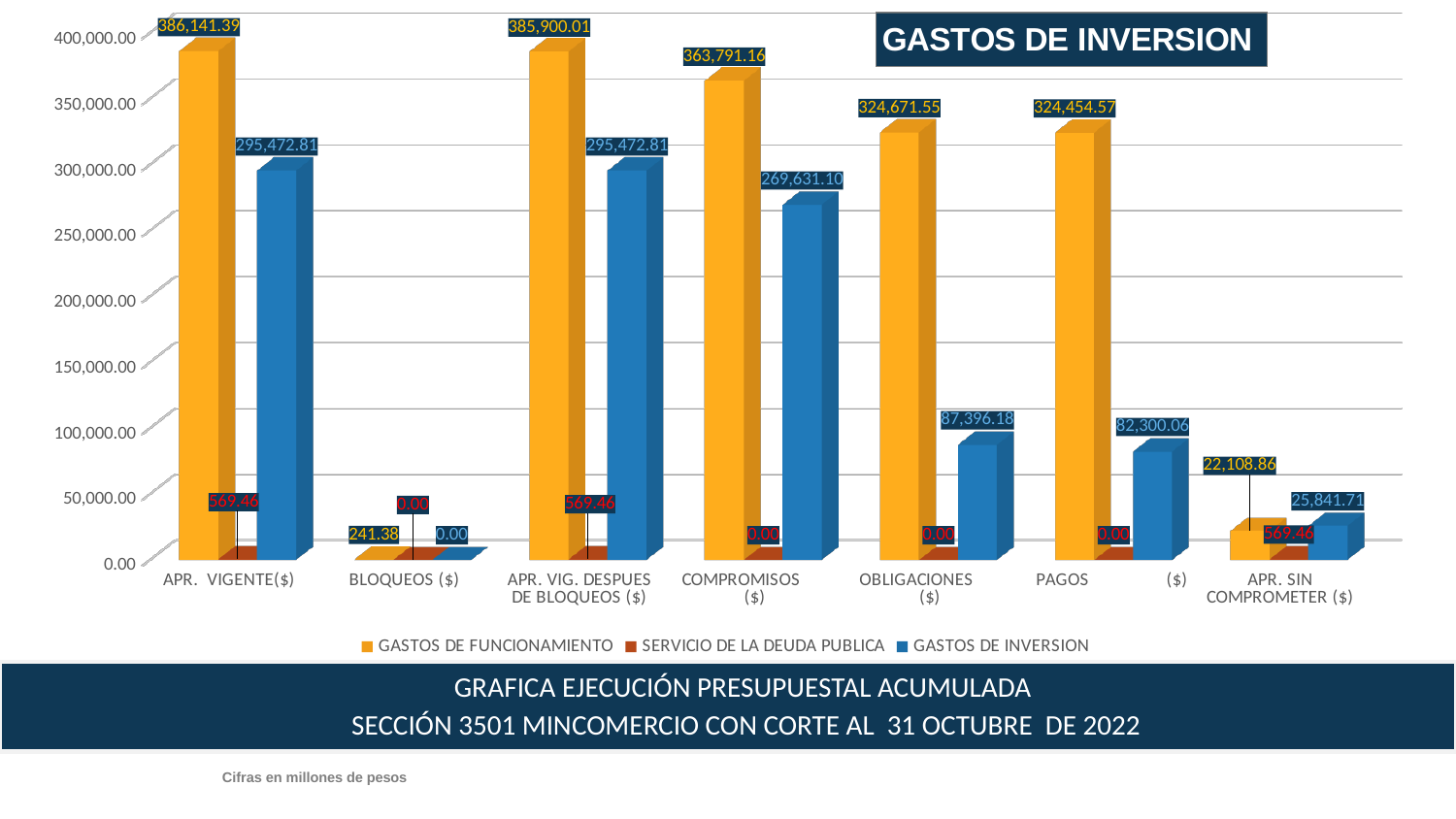
What is the value of GASTOS DE FUNCIONAMIENTO for BLOQUEOS ($)? 241.38 What is the difference between GASTOS DE FUNCIONAMIENTO for APR. VIGENTE($) and for APR. VIG. DESPUES DE BLOQUEOS ($)? 241.38 How many series does the legend list? 3 Which is larger for GASTOS DE INVERSION: OBLIGACIONES ($) or PAGOS ($)? OBLIGACIONES ($) What is the value of GASTOS DE INVERSION for OBLIGACIONES ($)? 87,396.18 Which category has the lowest value for GASTOS DE INVERSION? BLOQUEOS ($) What is the value of GASTOS DE FUNCIONAMIENTO for COMPROMISOS ($)? 363,791.16 For APR. SIN COMPROMETER ($), which series has the larger value: GASTOS DE FUNCIONAMIENTO or GASTOS DE INVERSION? GASTOS DE INVERSION How many categories are shown on the x axis? 7 Which category has the highest value for GASTOS DE FUNCIONAMIENTO? APR. VIGENTE($) What is the value of SERVICIO DE LA DEUDA PUBLICA for APR. VIGENTE($)? 569.46 What is the difference between GASTOS DE INVERSION for COMPROMISOS ($) and for OBLIGACIONES ($)? 182,234.92